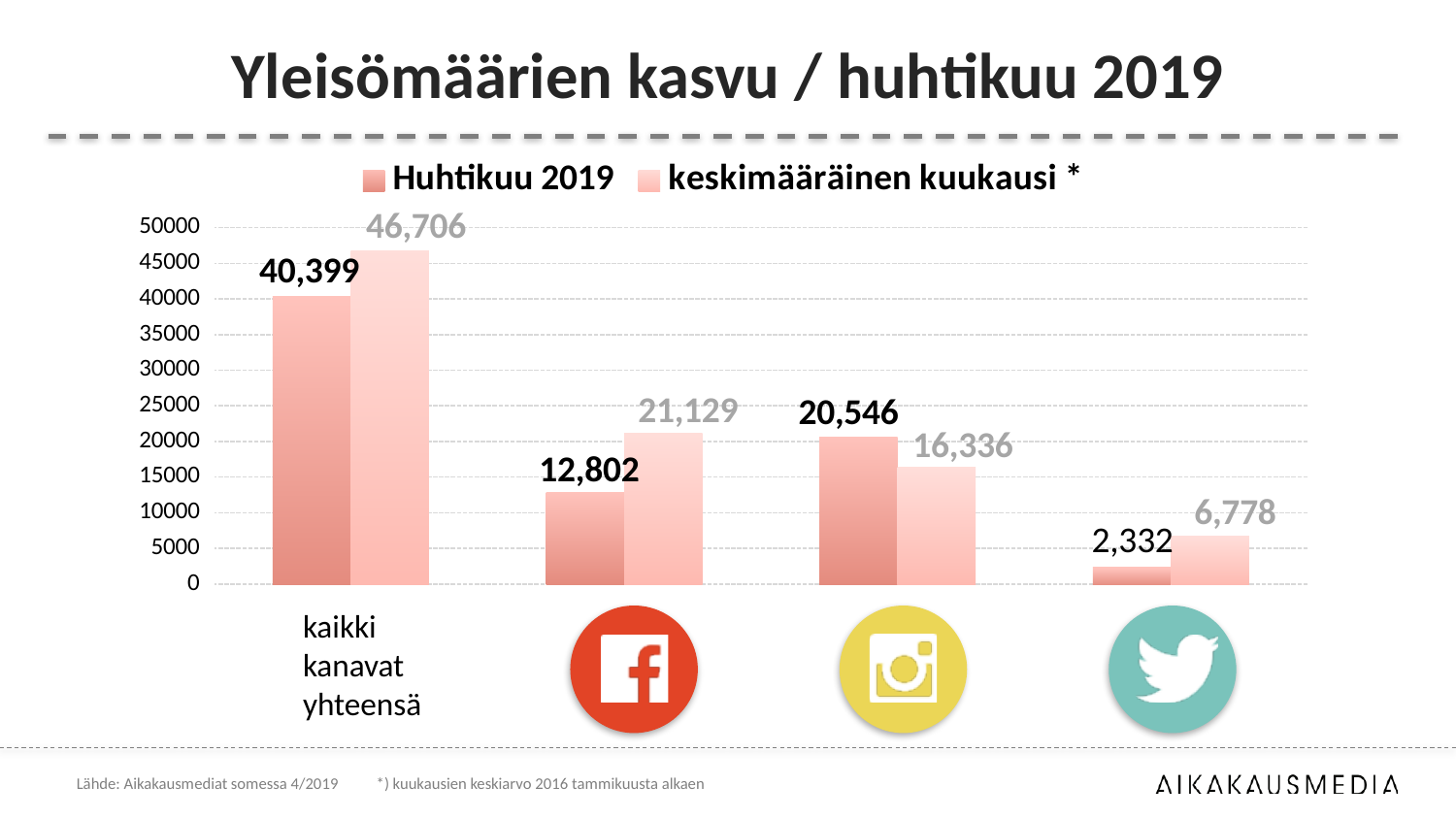
Which category has the highest keskimääräinen kuukausi value? kaikki kanavat yhteensä What is the difference between the keskimääräinen kuukausi value and the Huhtikuu 2019 value for the Facebook category? 8,327 What is the keskimääräinen kuukausi value for kaikki kanavat yhteensä? 46,706 What kind of chart is shown on the slide? bar chart What is the Huhtikuu 2019 value for the Facebook category? 12,802 For the Instagram category, which is larger: the Huhtikuu 2019 value or the keskimääräinen kuukausi value? Huhtikuu 2019 What is the Huhtikuu 2019 value for the Twitter category? 2,332 Which category has the lowest Huhtikuu 2019 value? Twitter How many categories are shown on the x axis? 4 What is the keskimääräinen kuukausi value for the Instagram category? 16,336 How many series does the legend list? 2 What is the Huhtikuu 2019 value for kaikki kanavat yhteensä? 40,399